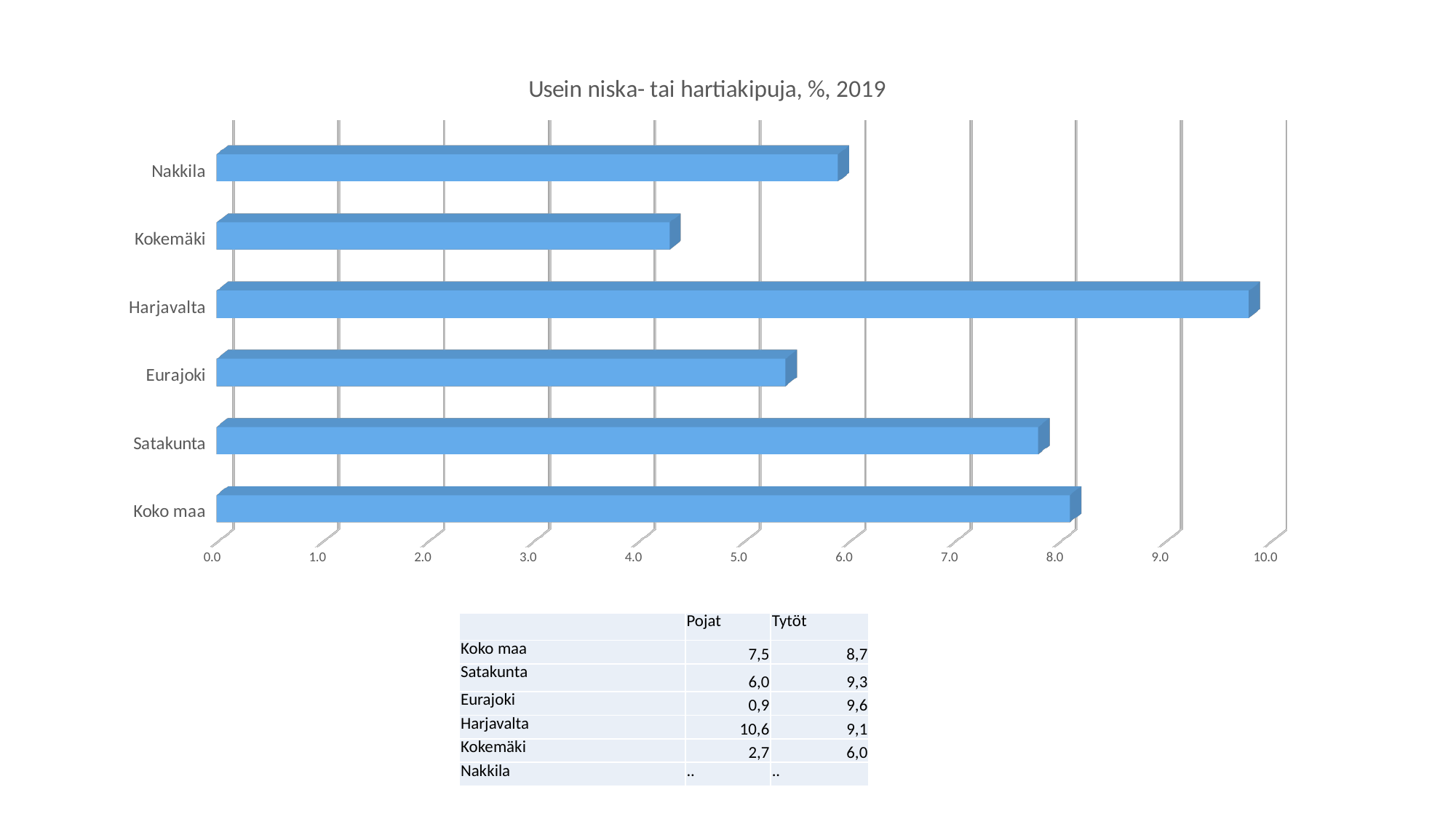
What is the title of the chart? Usein niska- tai hartiakipuja, %, 2019 How many categories are plotted in the chart? 6 Is the value for Eurajoki greater or less than 6.0? less Is the value for Harjavalta greater or less than 9.0? greater Is the value for Kokemäki greater or less than 5.0? less Which category has the lowest value in the chart? Kokemäki Which category has the highest value in the chart? Harjavalta What kind of chart is shown on the slide? bar chart Which has the larger value, Harjavalta or Satakunta? Harjavalta Which has the larger value, Kokemäki or Eurajoki? Eurajoki